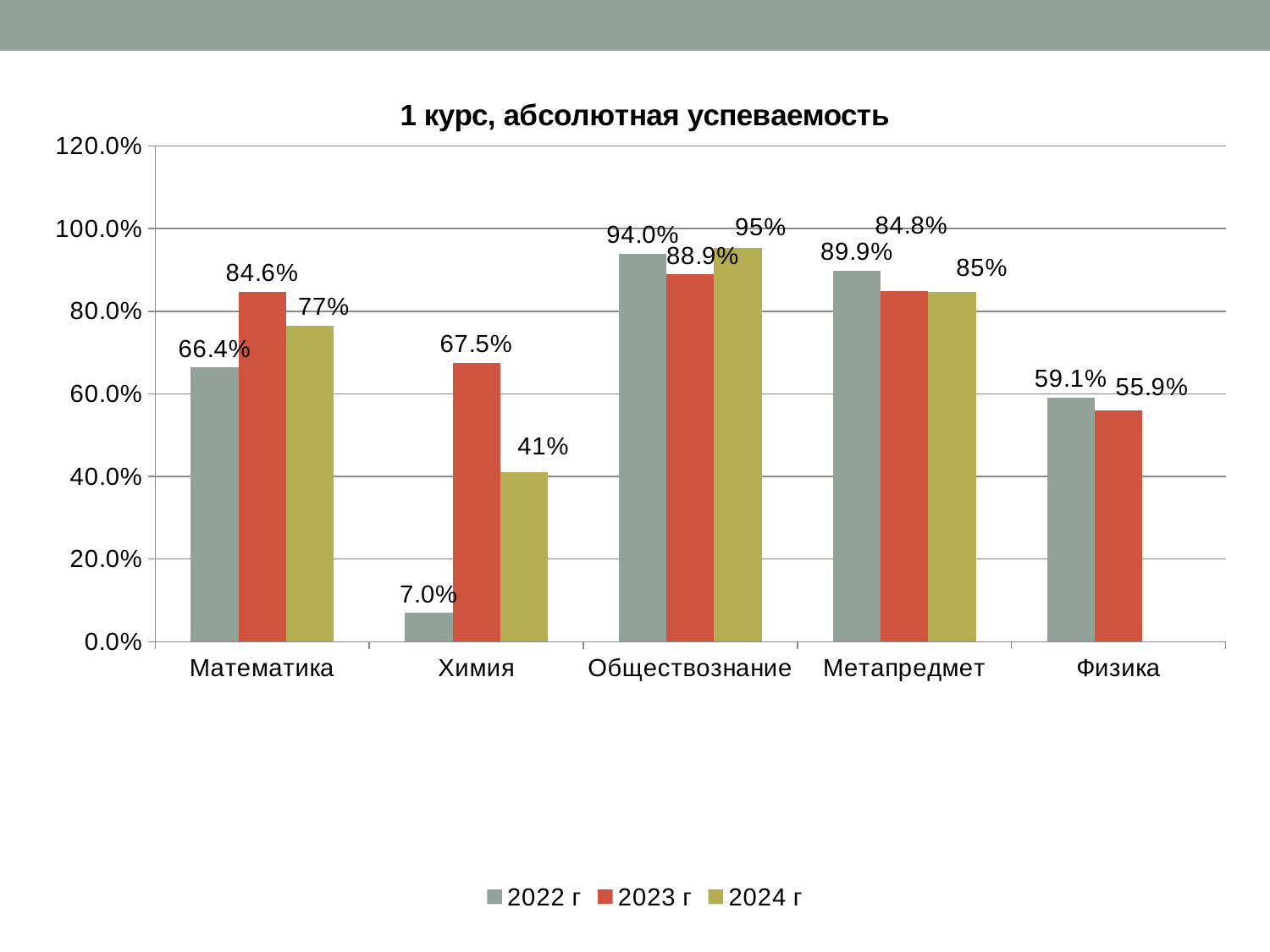
What kind of chart is shown on the slide? bar chart What is the difference between the 2023 г and 2022 г values for Математика? 18.2% Which category has the lowest value in the 2022 г series? Химия Which is larger for Метапредмет: the 2022 г value or the 2024 г value? 2022 г What is the value for Обществознание in the 2024 г series? 95% What is the value for Химия in the 2022 г series? 7.0% Which category has no bar for the 2024 г series? Физика What is the value for Физика in the 2023 г series? 55.9% What is the title of the chart? 1 курс, абсолютная успеваемость How many categories are shown on the x axis? 5 How many series does the legend list? 3 Which category has the highest value in the 2023 г series? Обществознание